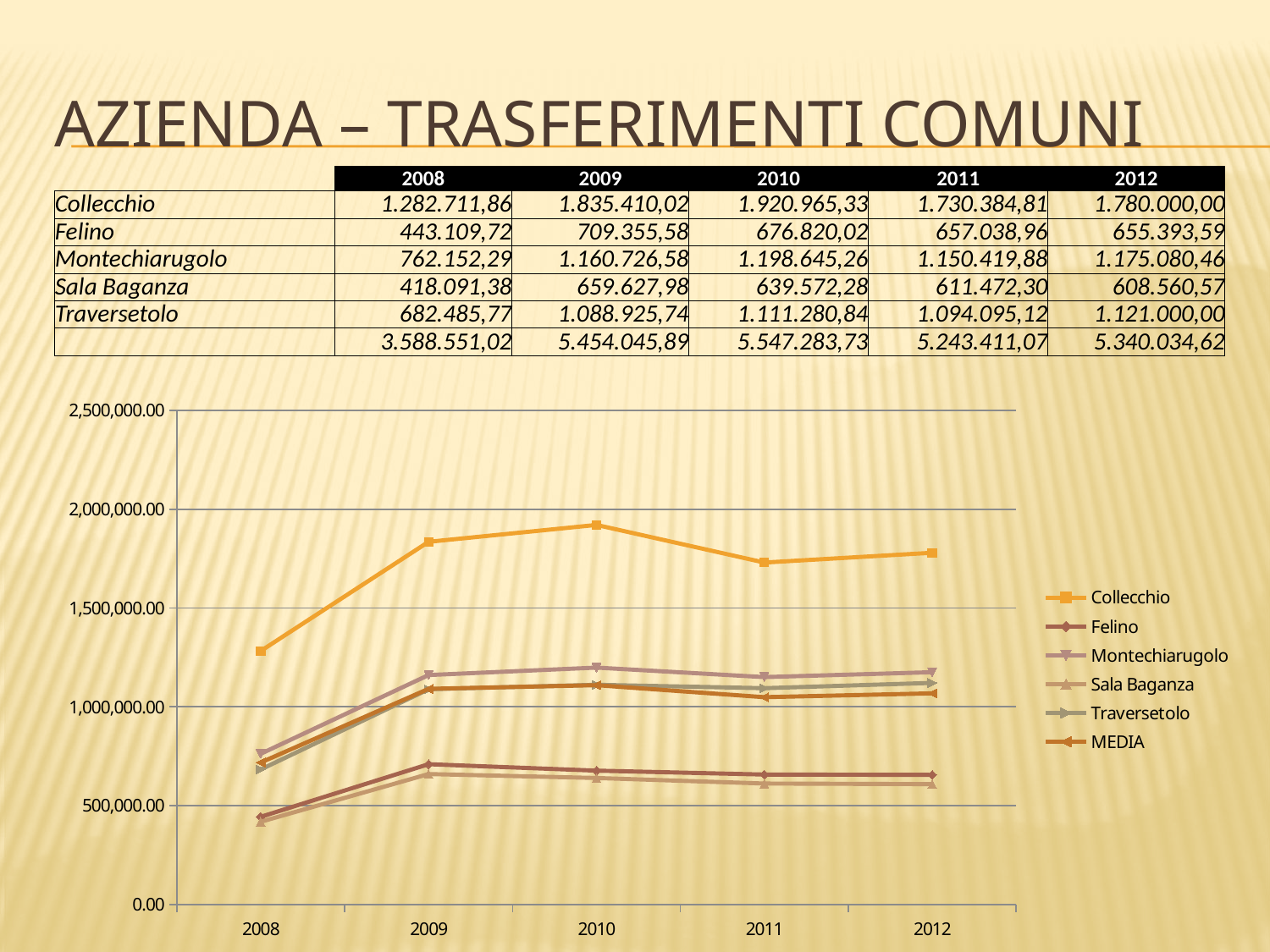
What kind of chart is shown on the slide? line chart What is the value for Collecchio in 2010? 1.920.965,33 Does the value for Collecchio rise or fall from 2008 to 2009? rise Which legend entry in the chart does not appear as a row in the table above it? MEDIA How many years are plotted along the x axis of the chart? 5 Is the value for Felino in 2009 greater or less than 1,000,000.00? less How many series does the chart legend list? 6 What is the value for Sala Baganza in 2008? 418.091,38 In which year is the value for Collecchio lowest? 2008 Is the value for Collecchio in 2010 greater or less than 1,500,000.00? greater Which series has the highest values in the chart? Collecchio Which is larger in 2012, the value for Collecchio or the value for Felino? Collecchio